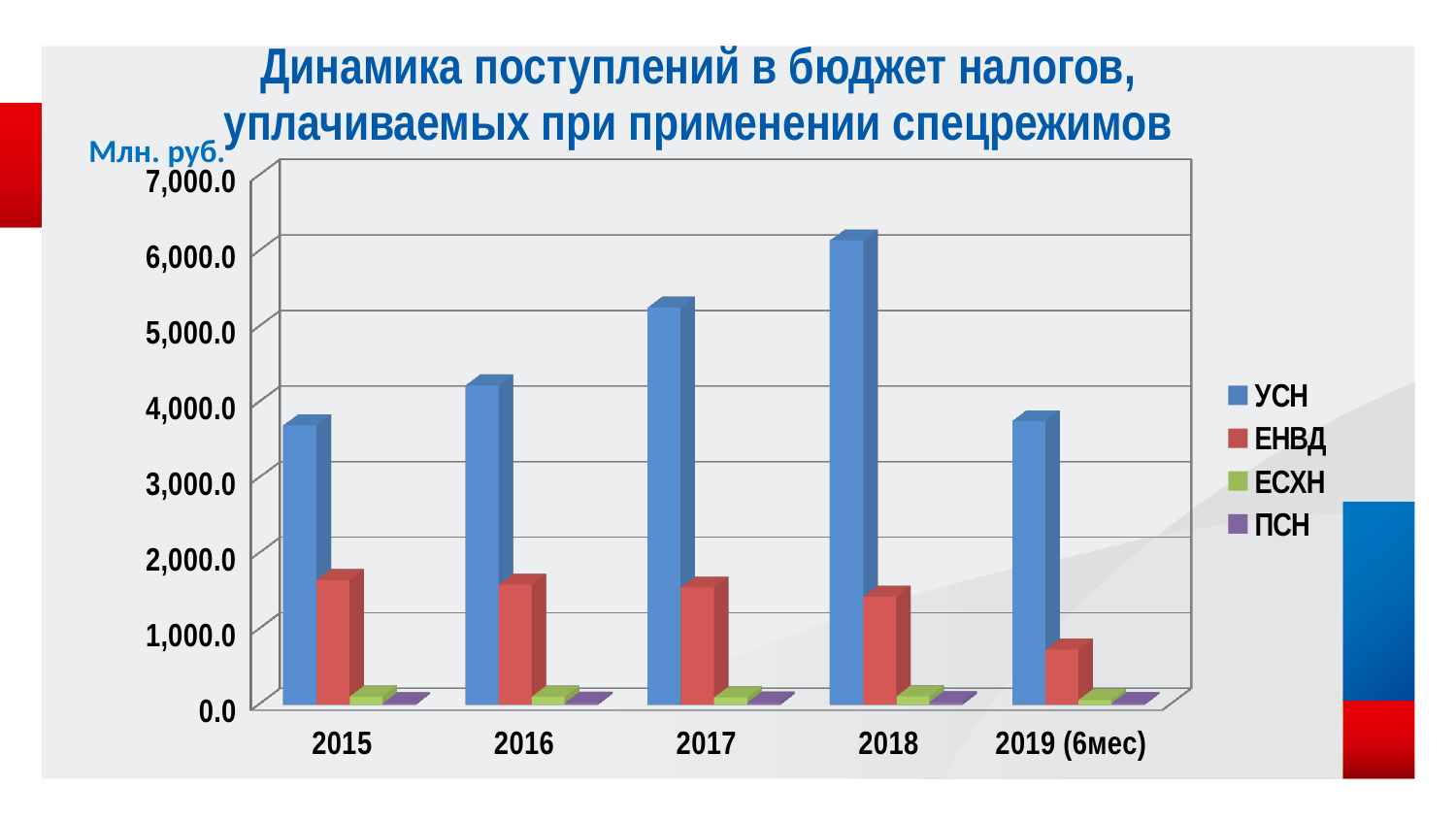
Do the УСН values rise or fall from 2015 to 2018? rise Is the value for ЕНВД in 2019 (6мес) greater or less than 1,000.0? less In which year is the УСН bar the highest? 2018 How many series does the legend list? 4 What kind of chart is shown on the slide? bar chart Is the value for УСН in 2015 greater or less than 4,000.0? less Is the value for ЕНВД in 2015 greater or less than 1,000.0? greater In which period is the ЕНВД bar the lowest? 2019 (6мес) How many year categories are shown on the x axis? 5 What unit is shown for the vertical axis? Млн. руб. Which is larger in 2017, the УСН value or the ЕНВД value? УСН